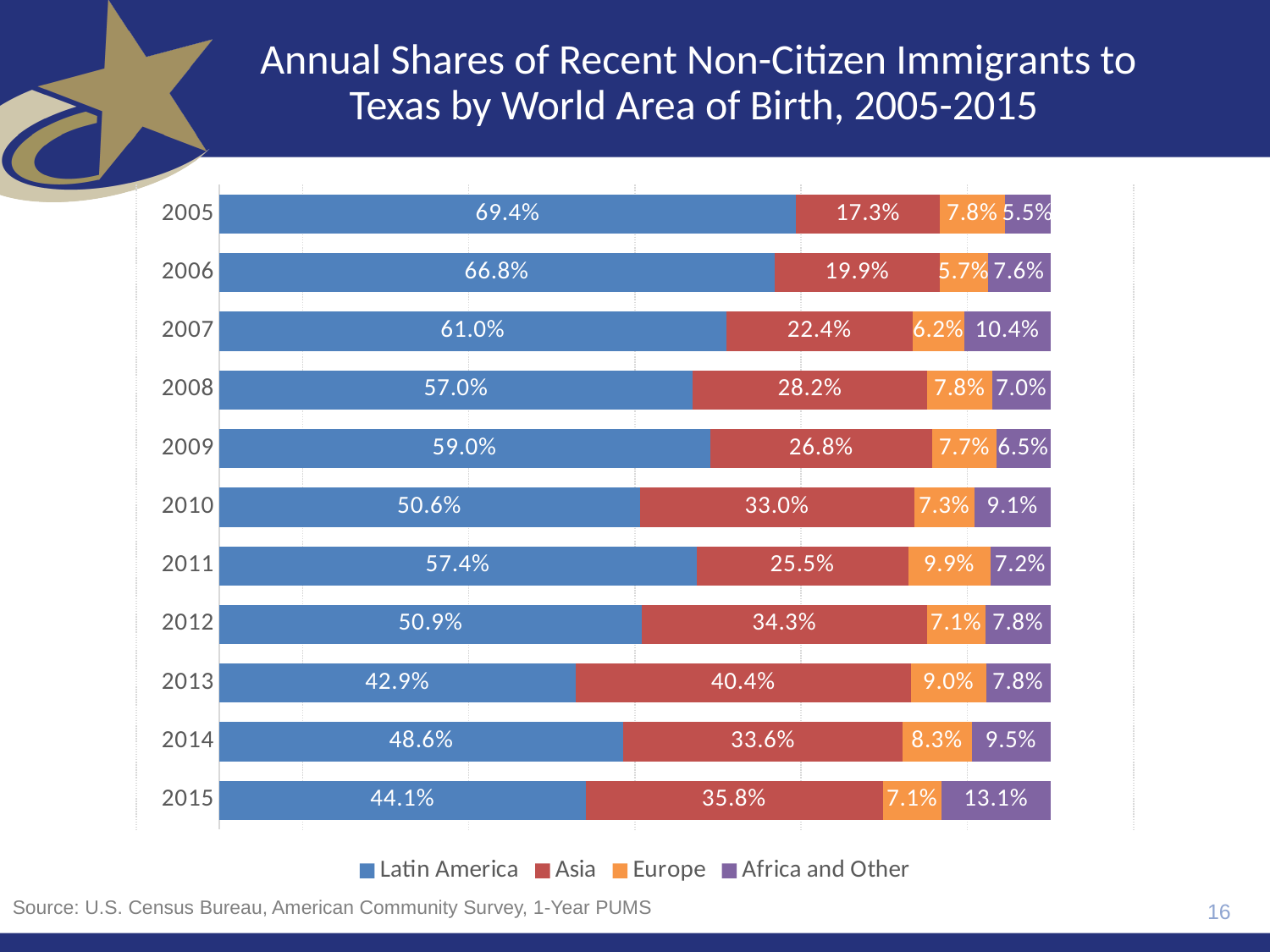
How many series does the legend list? 4 What was the Asia share in 2013? 40.4% What was the Africa and Other share in 2015? 13.1% What share of recent non-citizen immigrants to Texas in 2005 were born in Latin America? 69.4% In which year was the Latin America share highest? 2005 What is the difference between the Latin America share in 2005 and in 2015? 25.3 percentage points What kind of chart is shown on the slide? Stacked bar chart In which year was the Asia share highest? 2013 Which was larger in 2010, the Europe share or the Africa and Other share? Africa and Other What was the Europe share in 2011? 9.9% In which year was the Latin America share lowest? 2013 How many years are shown in the chart? 11